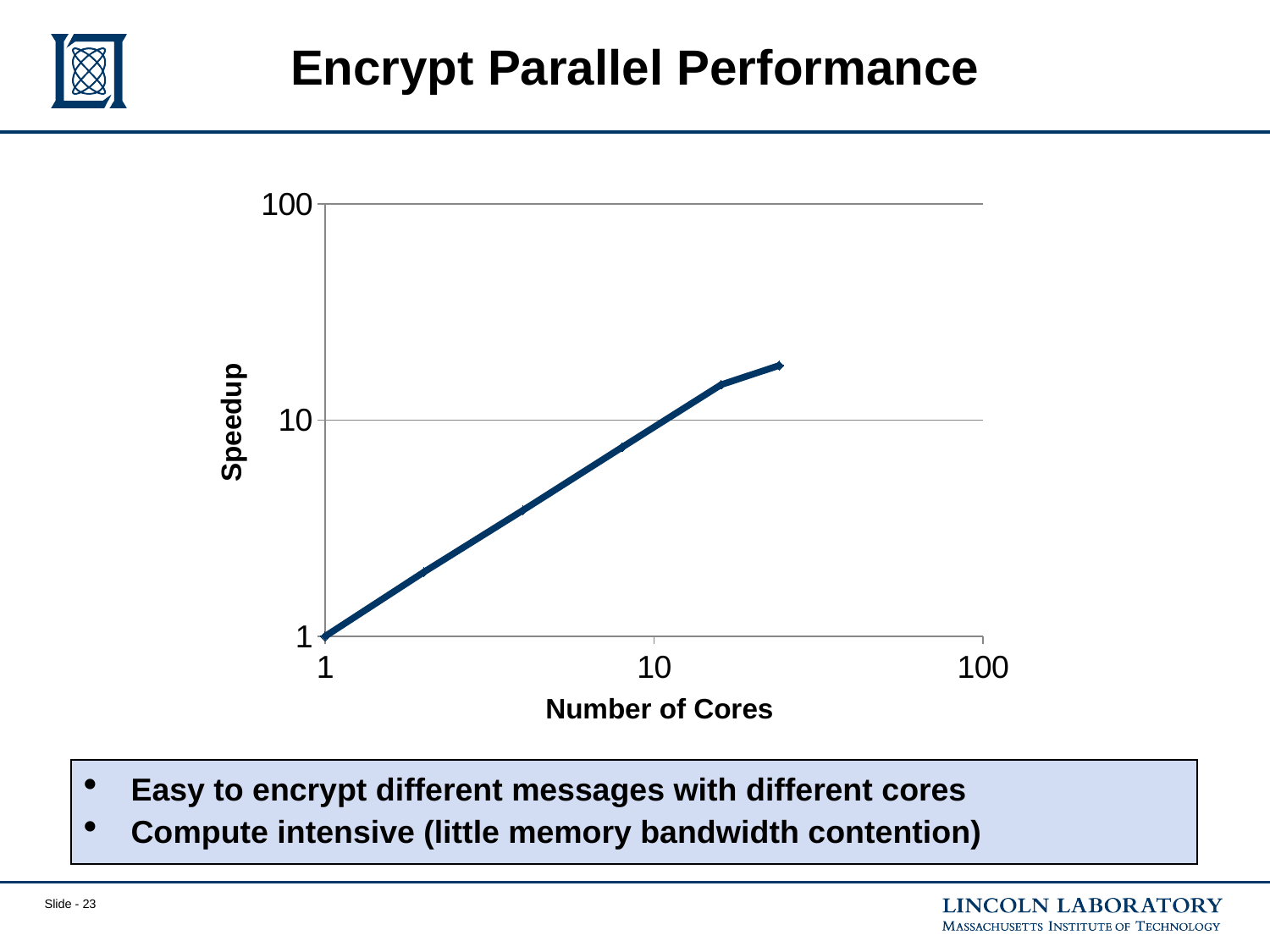
Is the speedup at 16 cores greater or less than 10? greater What is the largest value shown on the x axis? 100 What is the speedup at 1 core? 1 Does the speedup rise or fall as the number of cores increases? rise What is the label of the x axis? Number of Cores Is the speedup at 8 cores greater or less than 10? less How many data points are plotted on the line? 6 What is the label of the y axis? Speedup Is the highest speedup shown greater or less than 100? less What kind of chart is shown on the slide? line chart